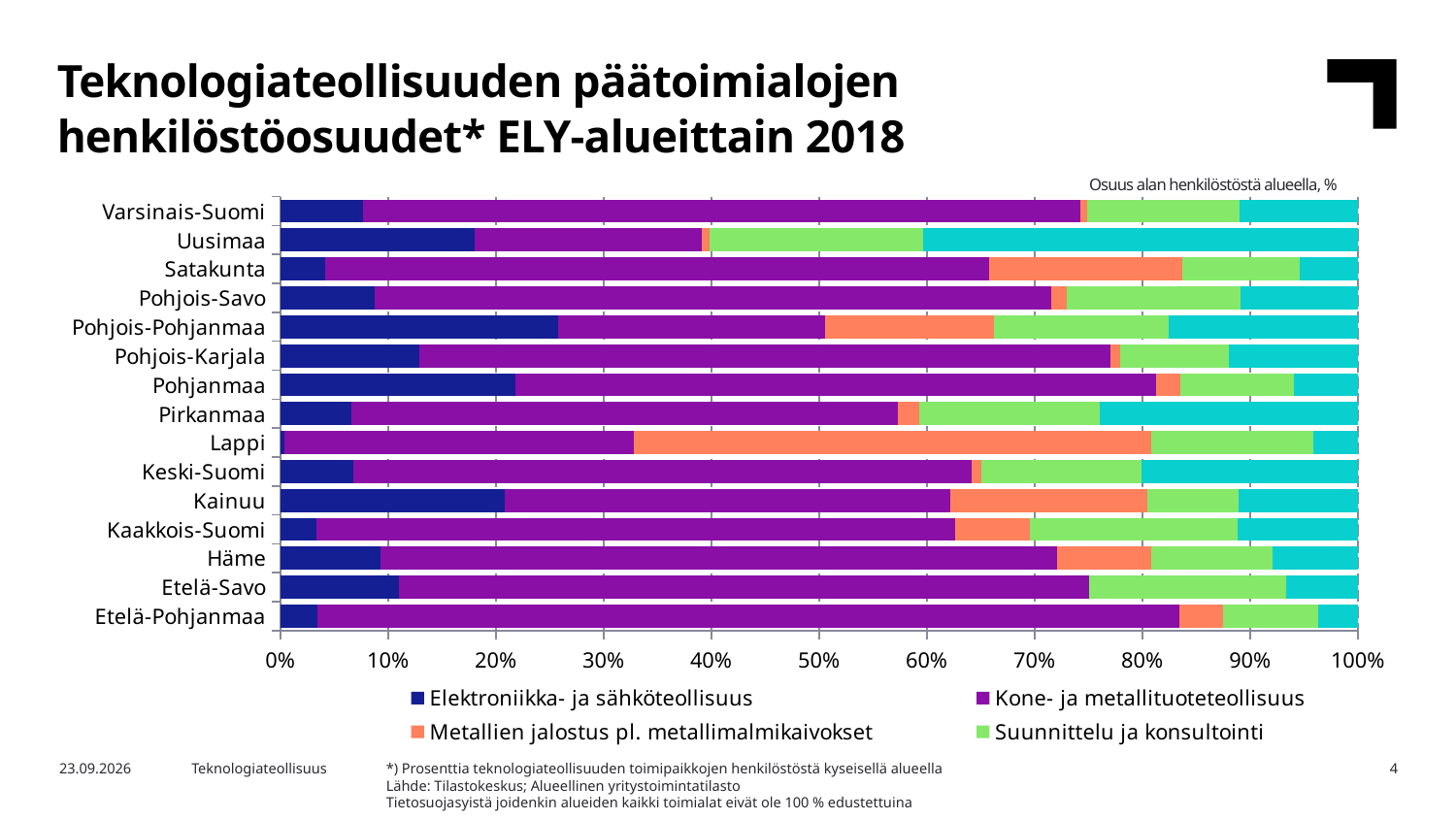
What is the title of the chart on the slide? Teknologiateollisuuden päätoimialojen henkilöstöosuudet* ELY-alueittain 2018 Which region has the smallest share for Elektroniikka- ja sähköteollisuus? Lappi Is the Kone- ja metallituoteteollisuus share for Lappi greater or less than 40%? less How many series does the chart's legend list? 4 What kind of chart is shown on the slide? Stacked bar chart Is the Elektroniikka- ja sähköteollisuus share for Uusimaa greater or less than 10%? greater Which region has the largest share for Metallien jalostus pl. metallimalmikaivokset? Lappi Which region has the larger Elektroniikka- ja sähköteollisuus share, Uusimaa or Varsinais-Suomi? Uusimaa How many ELY regions are listed on the vertical axis of the chart? 15 Is the Metallien jalostus pl. metallimalmikaivokset share for Lappi greater or less than 40%? greater Which region has the largest share for Elektroniikka- ja sähköteollisuus? Pohjois-Pohjanmaa Which region has the largest share for Kone- ja metallituoteteollisuus? Etelä-Pohjanmaa